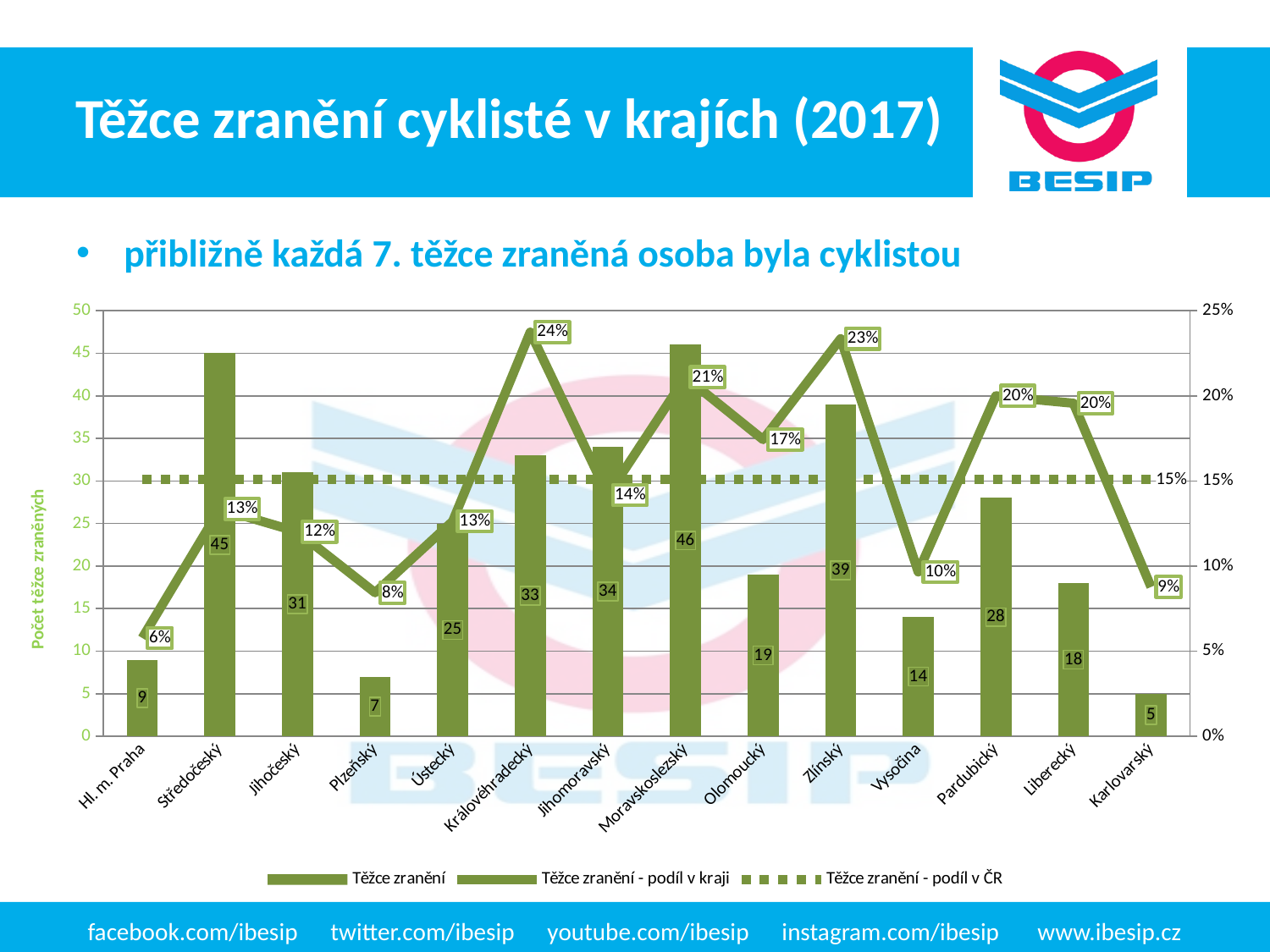
What is the title of the chart's vertical axis on the left? Počet těžce zraněných How many regions are shown on the x axis? 14 Which region has the highest number of seriously injured cyclists (bar)? Moravskoslezský Which region has the lowest share in the region (Těžce zranění - podíl v kraji)? Hl. m. Praha Which has more seriously injured cyclists, Zlínský or Pardubický? Zlínský What value does the dashed line (Těžce zranění - podíl v ČR) show? 15% Which region has the lowest number of seriously injured cyclists (bar)? Karlovarský How many series does the legend list? 3 What is the share in the region (Těžce zranění - podíl v kraji) for Královéhradecký? 24% What is the number of seriously injured cyclists (Těžce zranění) for Moravskoslezský? 46 What is the share in the region (Těžce zranění - podíl v kraji) for Olomoucký? 17% What is the difference between the number of seriously injured cyclists in Středočeský and Jihočeský? 14